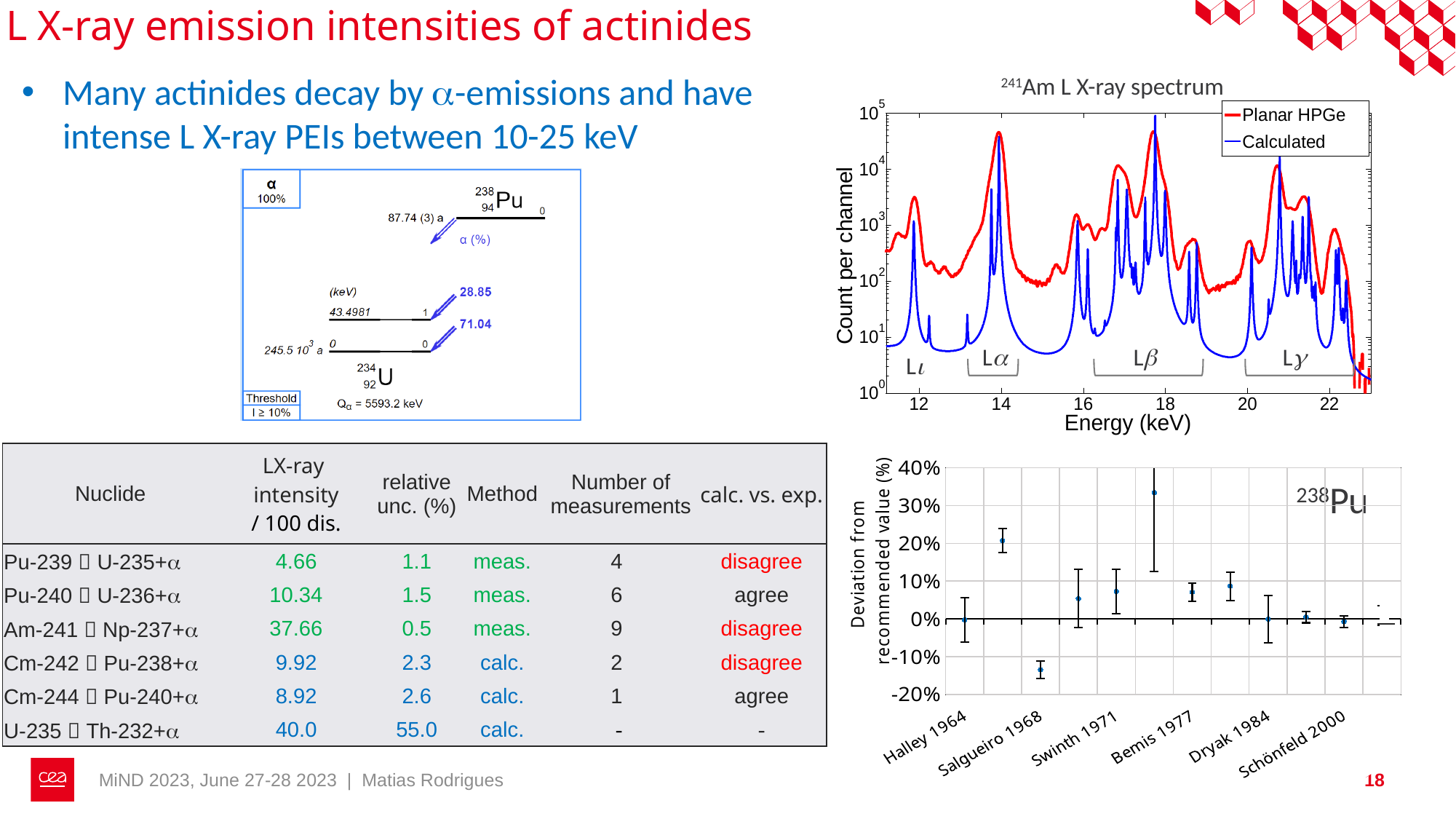
In the 241Am L X-ray spectrum chart, what is the label of the x axis? Energy (keV) What kind of chart is the 241Am L X-ray spectrum? Line chart In the 241Am L X-ray spectrum chart, what are the two legend entries? Planar HPGe and Calculated In the 241Am L X-ray spectrum chart, which series is drawn in red? Planar HPGe In the 238Pu deviation chart, is the highest plotted deviation greater or less than 30%? greater In the 238Pu deviation chart, is the lowest plotted deviation greater or less than -10%? less In the 241Am L X-ray spectrum chart, how many series does the legend list? 2 In the 241Am L X-ray spectrum chart, is the Planar HPGe peak near 12 keV greater or less than 10^3 counts per channel? greater In the 238Pu deviation chart, how many author/year labels are shown on the x axis? 6